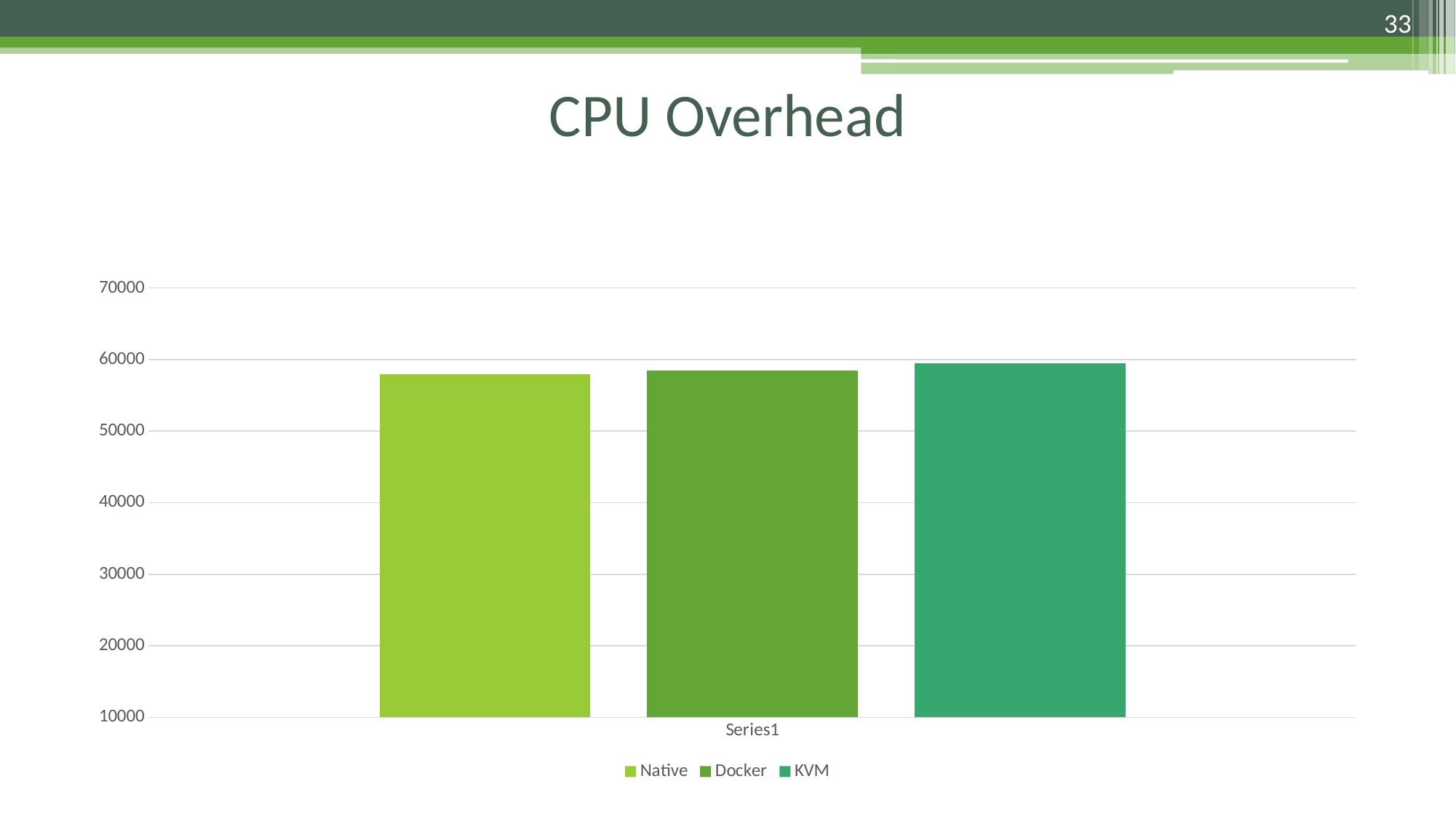
Is the value for Native greater or less than 60000? less What is the title of the chart? CPU Overhead What is the label on the x axis under the bars? Series1 Is the value for KVM greater or less than 50000? greater Which series has the highest bar? KVM What kind of chart is shown on the slide? bar chart Which is larger, the value for KVM or the value for Native? KVM Is the value for Docker greater or less than 60000? less How many bars are plotted in the chart? 3 How many series does the legend list? 3 Which series are listed in the legend? Native, Docker, KVM